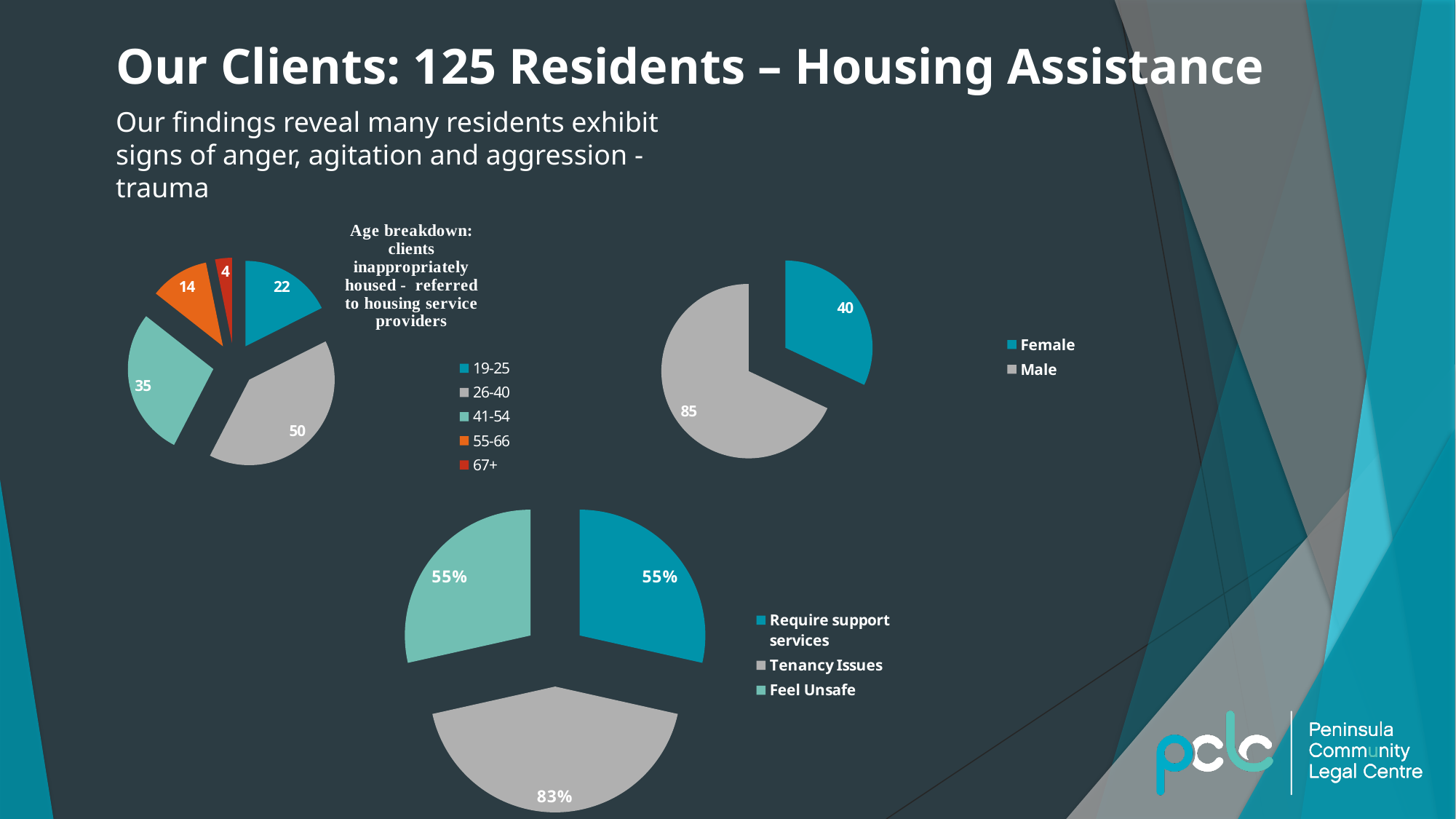
In the age breakdown pie chart, what is the value for the 26-40 age group? 50 In the top-right pie chart showing Female and Male, what is the difference between the Male and Female values? 45 In the age breakdown pie chart, which age group has the largest value? 26-40 In the age breakdown pie chart, which age group has the smallest value? 67+ In the top-right pie chart showing Female and Male, which category is larger, Female or Male? Male In the top-right pie chart showing Female and Male, what is the value for Male? 85 How many age groups are shown in the age breakdown pie chart? 5 In the top-right pie chart showing Female and Male, what share of the total does Female represent? 32% In the bottom pie chart, what is the value for Tenancy Issues? 83% In the age breakdown pie chart, what is the difference between the values for 41-54 and 55-66? 21 What type of chart is the bottom chart on the slide? Pie chart In the age breakdown pie chart, what is the value for the 67+ age group? 4